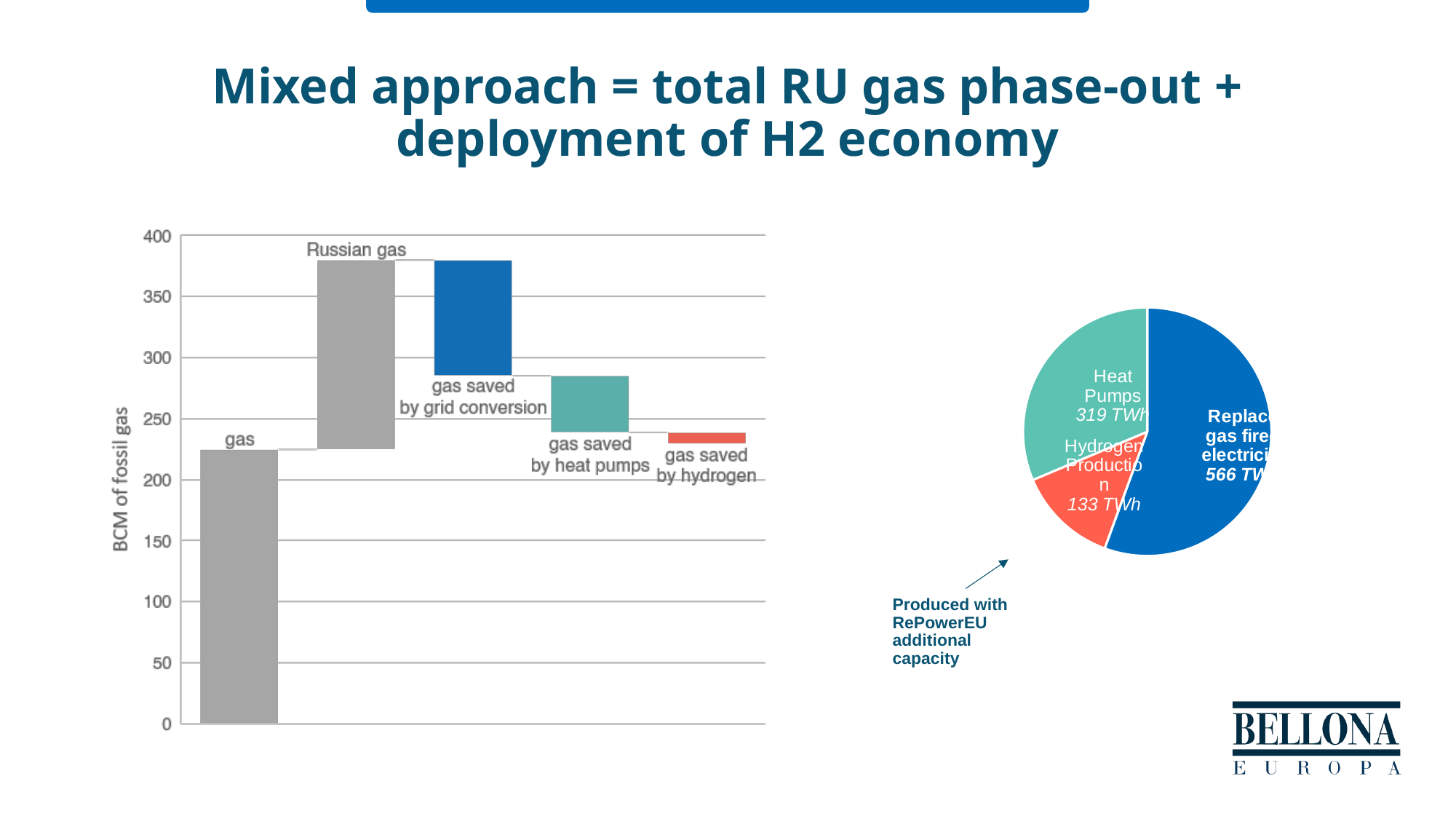
In the pie chart on the right, what value is shown for Heat Pumps? 319 TWh In the bar chart on the left, does the top of the 'Russian gas' bar lie above or below 350? above In the bar chart on the left, what is the label of the vertical axis? BCM of fossil gas In the bar chart on the left, how many bars are plotted? 5 What kind of chart is the chart on the left of the slide? bar chart In the pie chart on the right, how many slices are there? 3 What kind of chart is the chart on the right of the slide? pie chart In the pie chart on the right, how much larger is the Heat Pumps value than the Hydrogen Production value? 186 TWh In the pie chart on the right, what value is shown for Hydrogen Production? 133 TWh In the bar chart on the left, which bar is the tallest (spans the largest range)? gas In the bar chart on the left, is the value for the 'gas' bar greater or less than 200? greater In the bar chart on the left, is the value for the 'gas' bar greater or less than 250? less